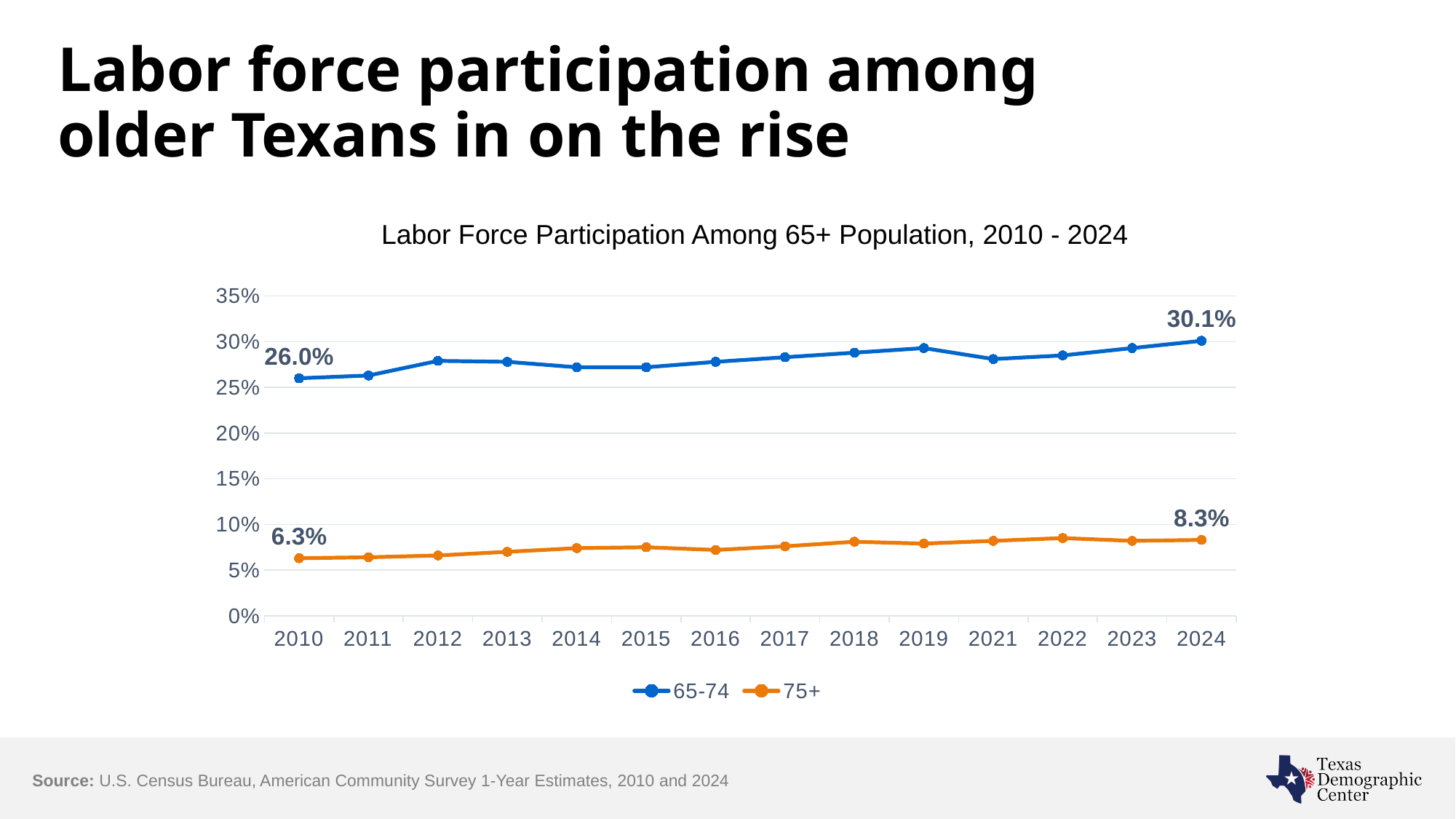
Is the value for the 65-74 group in 2019 greater or less than 25%? greater What is the labor force participation rate for the 65-74 group in 2010? 26.0% In 2024, which group has the higher labor force participation rate, 65-74 or 75+? 65-74 By how many percentage points did the 75+ participation rate change from 2010 to 2024? 2.0 percentage points What kind of chart is shown on the slide? Line chart What is the labor force participation rate for the 75+ group in 2024? 8.3% Is the value for the 75+ group in 2022 greater or less than 10%? less How many years are shown on the x axis of the chart? 14 How many series does the legend list? 2 By how many percentage points did the 65-74 participation rate change from 2010 to 2024? 4.1 percentage points What is the labor force participation rate for the 75+ group in 2010? 6.3% What is the labor force participation rate for the 65-74 group in 2024? 30.1%